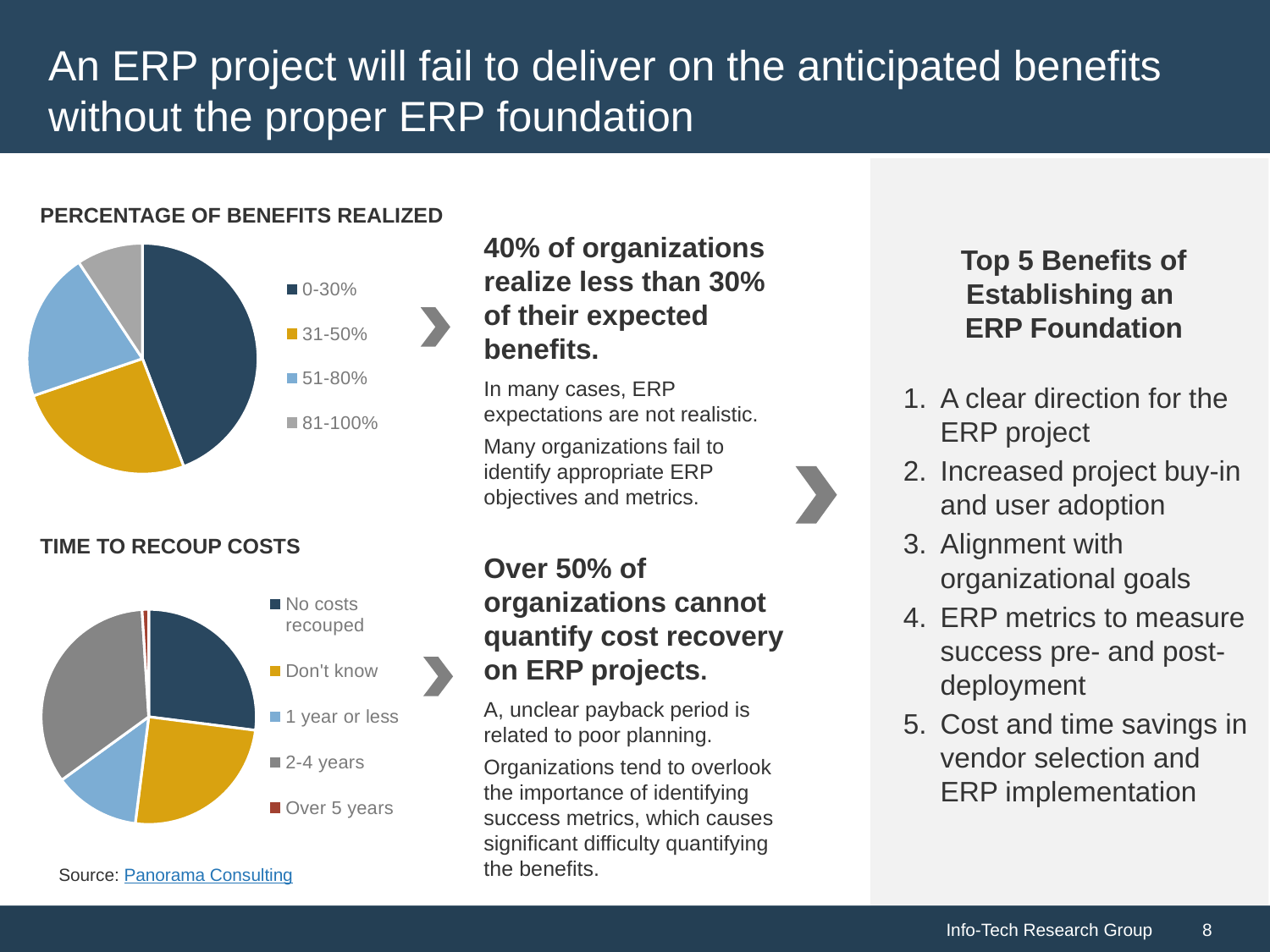
In the 'TIME TO RECOUP COSTS' chart, which slice is larger: 'Don't know' or '1 year or less'? Don't know In the 'TIME TO RECOUP COSTS' chart, what colour is the 'Over 5 years' slice? Red In the 'PERCENTAGE OF BENEFITS REALIZED' chart, which category has the largest slice? 0-30% In the 'TIME TO RECOUP COSTS' chart, how many categories does the legend list? 5 In the 'PERCENTAGE OF BENEFITS REALIZED' chart, what colour is the 81-100% slice? Gray In the 'TIME TO RECOUP COSTS' chart, which category has the smallest slice? Over 5 years In the 'TIME TO RECOUP COSTS' chart, which slice is larger: '2-4 years' or '1 year or less'? 2-4 years In the 'PERCENTAGE OF BENEFITS REALIZED' chart, which slice is larger: 31-50% or 51-80%? 31-50% What kind of chart is the 'PERCENTAGE OF BENEFITS REALIZED' chart? Pie chart In the 'PERCENTAGE OF BENEFITS REALIZED' chart, how many categories does the legend list? 4 In the 'PERCENTAGE OF BENEFITS REALIZED' chart, which category has the smallest slice? 81-100% What kind of chart is the 'TIME TO RECOUP COSTS' chart? Pie chart